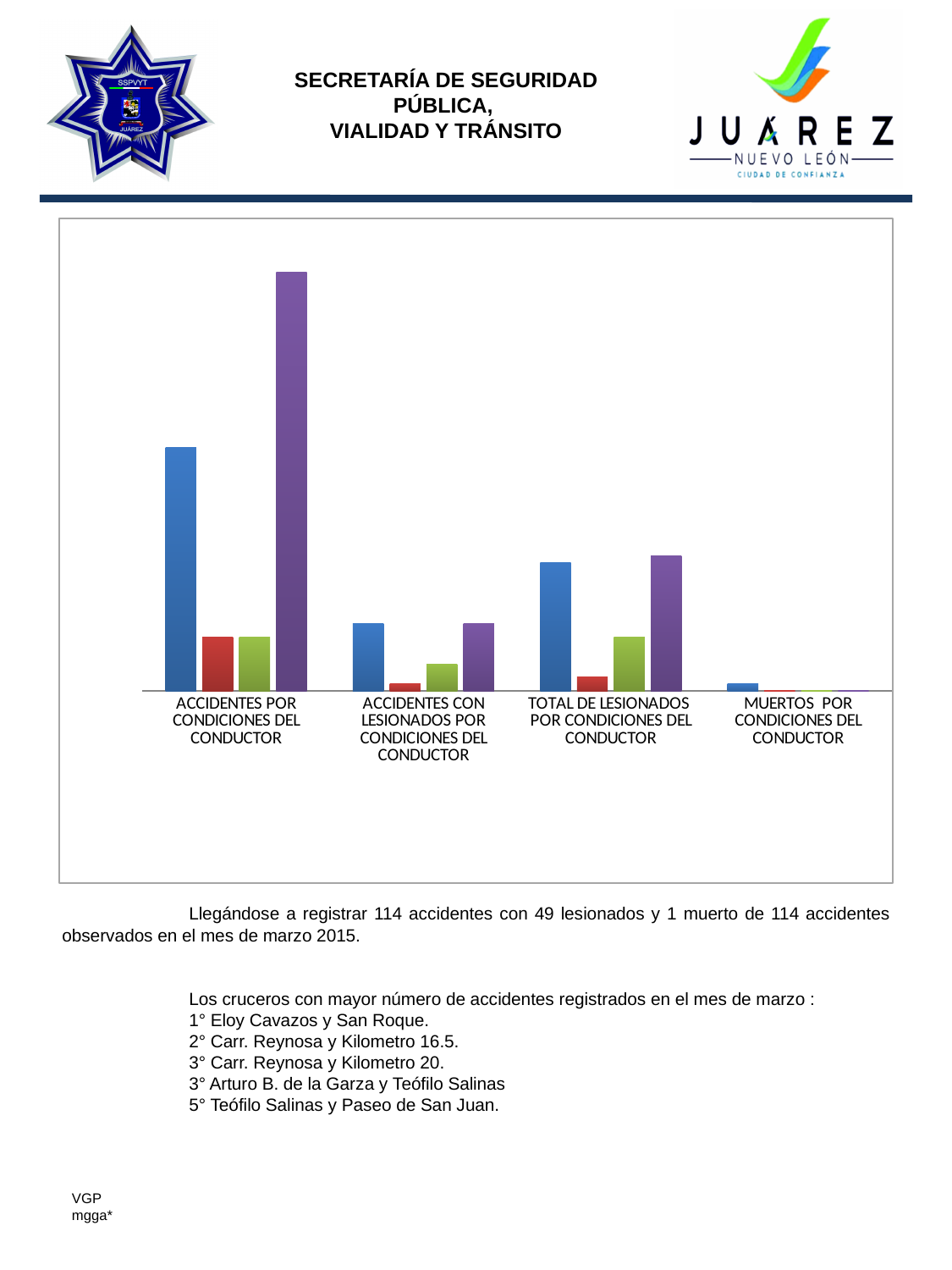
In the category ACCIDENTES CON LESIONADOS POR CONDICIONES DEL CONDUCTOR, which bar is taller, the red one or the green one? The green one Which category has the lowest bars in the chart? MUERTOS POR CONDICIONES DEL CONDUCTOR In the category ACCIDENTES POR CONDICIONES DEL CONDUCTOR, which bar is taller, the blue one or the purple one? The purple one Does the chart display a legend? No How many categories are shown along the x axis of the chart? 4 Which blue bar is taller, the one for ACCIDENTES POR CONDICIONES DEL CONDUCTOR or the one for TOTAL DE LESIONADOS POR CONDICIONES DEL CONDUCTOR? ACCIDENTES POR CONDICIONES DEL CONDUCTOR Which category contains the tallest bar in the chart? ACCIDENTES POR CONDICIONES DEL CONDUCTOR What kind of chart is shown on the slide? Bar chart How many bars are shown for each category in the chart? 4 In the category ACCIDENTES CON LESIONADOS POR CONDICIONES DEL CONDUCTOR, which bar is the shortest? The red one